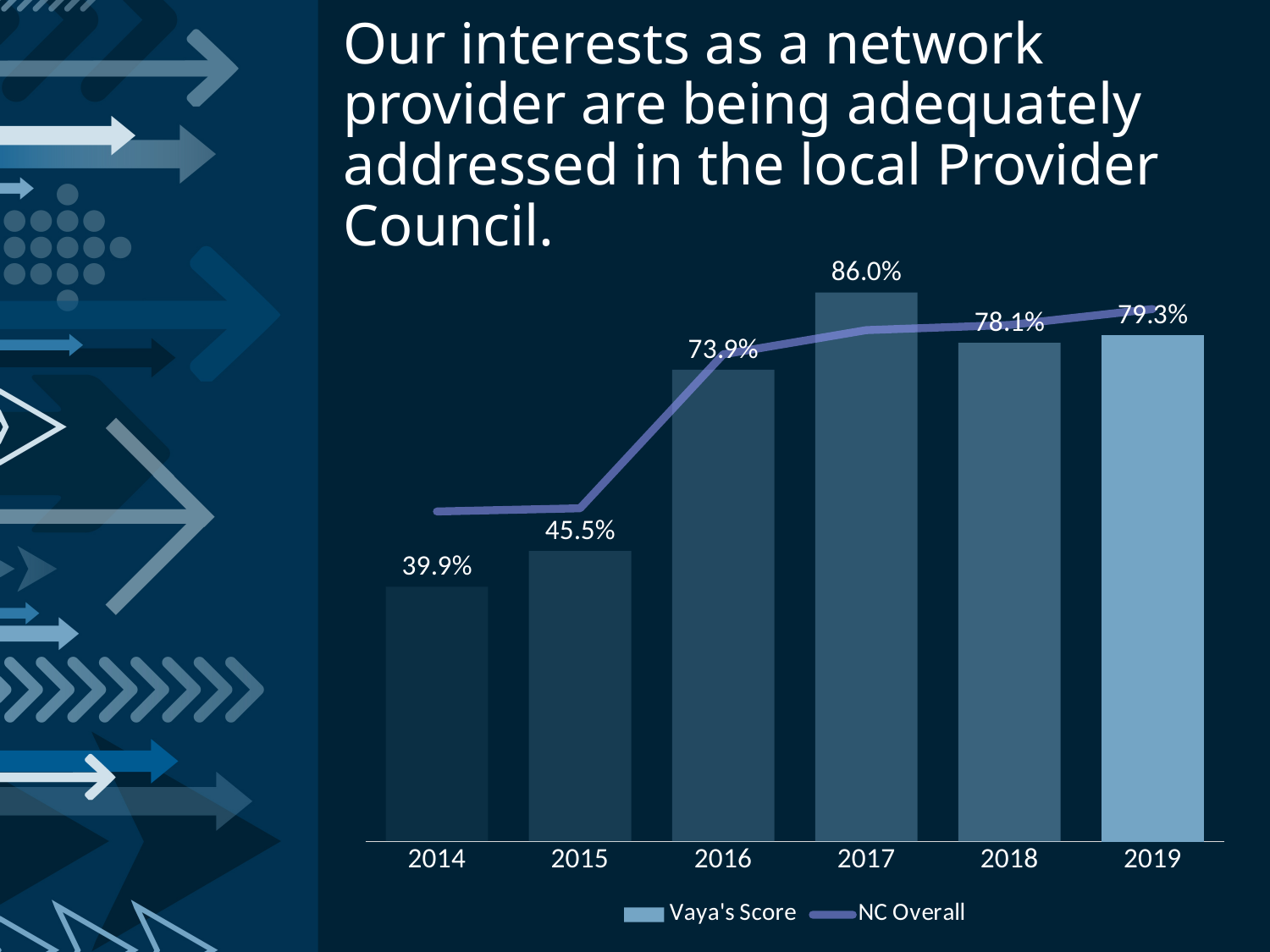
How many series does the legend list? 2 What is Vaya's Score for 2019? 79.3% Which year has the lowest Vaya's Score? 2014 Which is larger, Vaya's Score in 2018 or in 2019? 2019 What is the difference between Vaya's Score in 2017 and in 2018? 7.9% Does Vaya's Score rise or fall from 2014 to 2017? Rise What kind of chart is shown on the slide? A bar chart with a line series Which year has the highest Vaya's Score? 2017 What is Vaya's Score for 2014? 39.9% What is the difference between Vaya's Score in 2016 and in 2015? 28.4% What is Vaya's Score for 2017? 86.0% How many years are shown on the x axis? 6